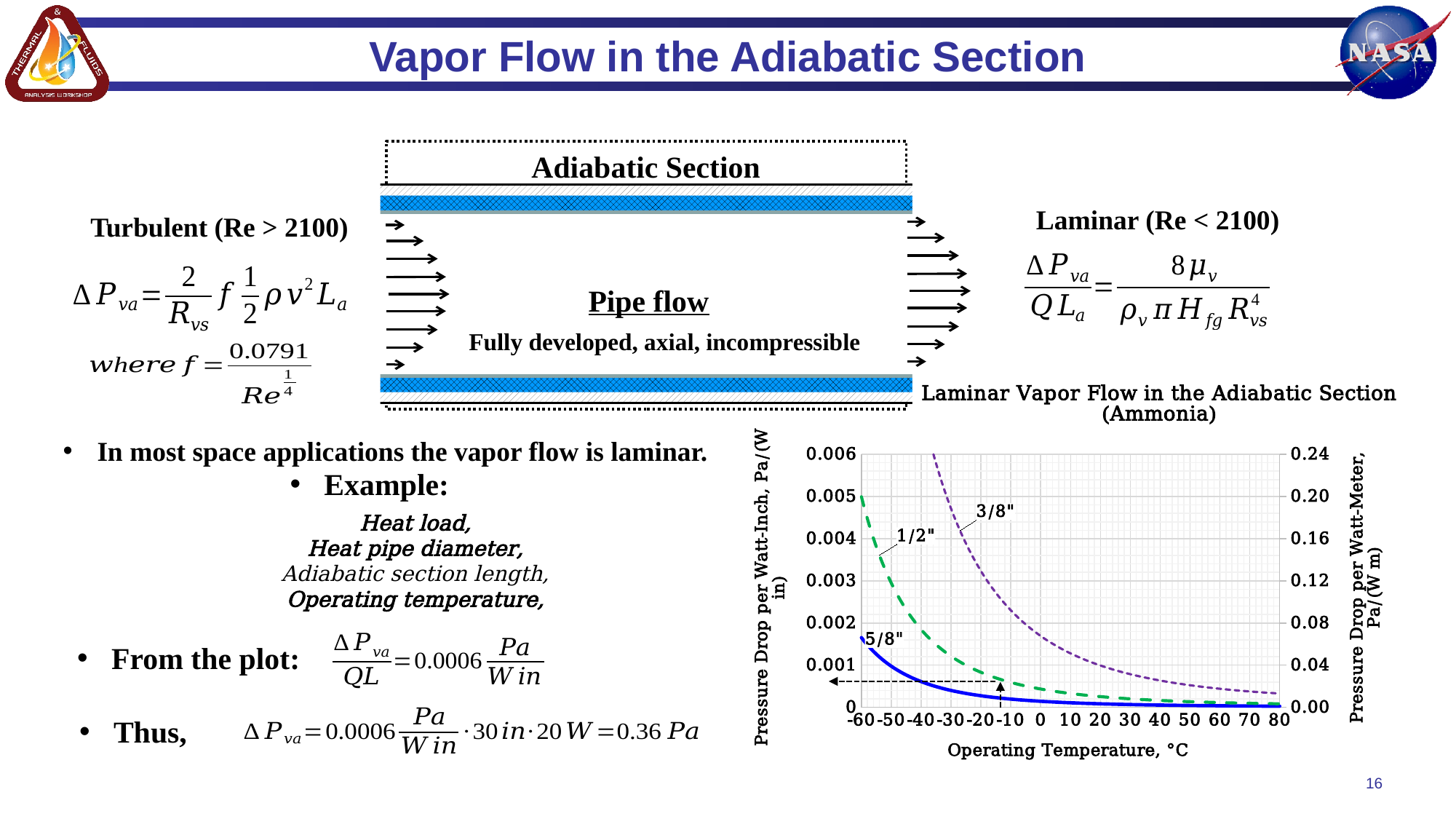
Do the pressure drop curves rise or fall as operating temperature increases? fall Which diameter curve has the highest pressure drop per watt-inch at any given temperature? 3/8" What kind of chart is shown on the slide? line chart Which diameter curve has the lowest pressure drop per watt-inch at any given temperature? 5/8" Is the pressure drop per watt-inch for the 5/8" curve at -60 °C greater or less than 0.001? greater What is the label of the x axis of the chart? Operating Temperature, °C Is the pressure drop per watt-inch for the 5/8" curve at -60 °C greater or less than 0.002? less What is the title of the chart on the slide? Laminar Vapor Flow in the Adiabatic Section (Ammonia) How many heat pipe diameter curves are plotted on the chart? 3 At 0 °C, which curve shows a larger pressure drop per watt-inch, 3/8" or 5/8"? 3/8"